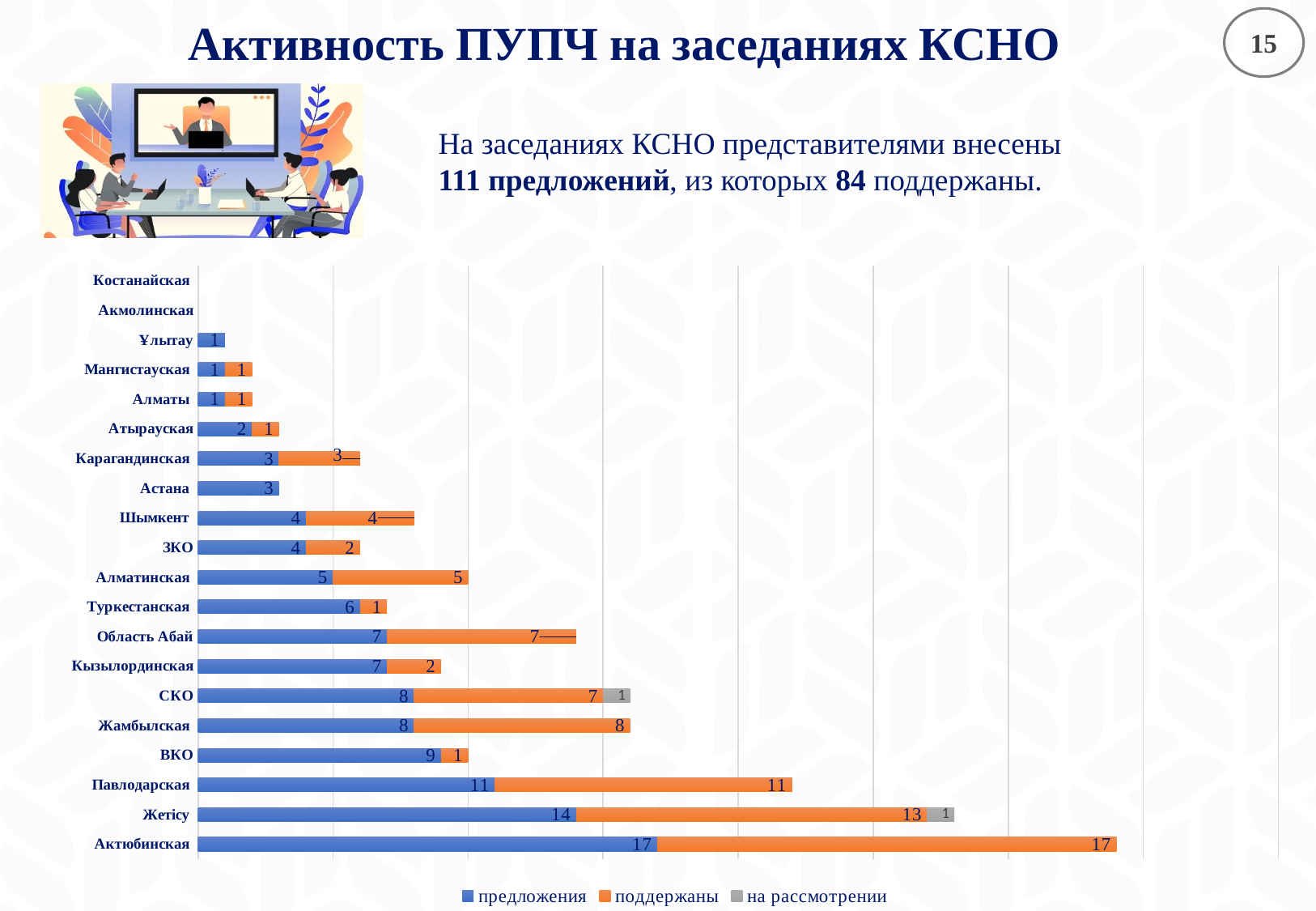
What is the value of на рассмотрении for СКО? 1 What is the value of поддержаны for Жетісу? 13 What is the value of предложения for Туркестанская? 6 Which series in the legend is shown in orange? поддержаны How many regions (categories) are listed on the chart's vertical axis? 20 What is the total of the stacked bar for Жетісу? 28 What is the difference between предложения and поддержаны for ВКО? 8 What is the value of предложения for Актюбинская? 17 Which is larger: поддержаны for Павлодарская or поддержаны for Жамбылская? Павлодарская What kind of chart is shown on the slide? bar chart How many series does the chart legend list? 3 Which region has the highest value of предложения? Актюбинская